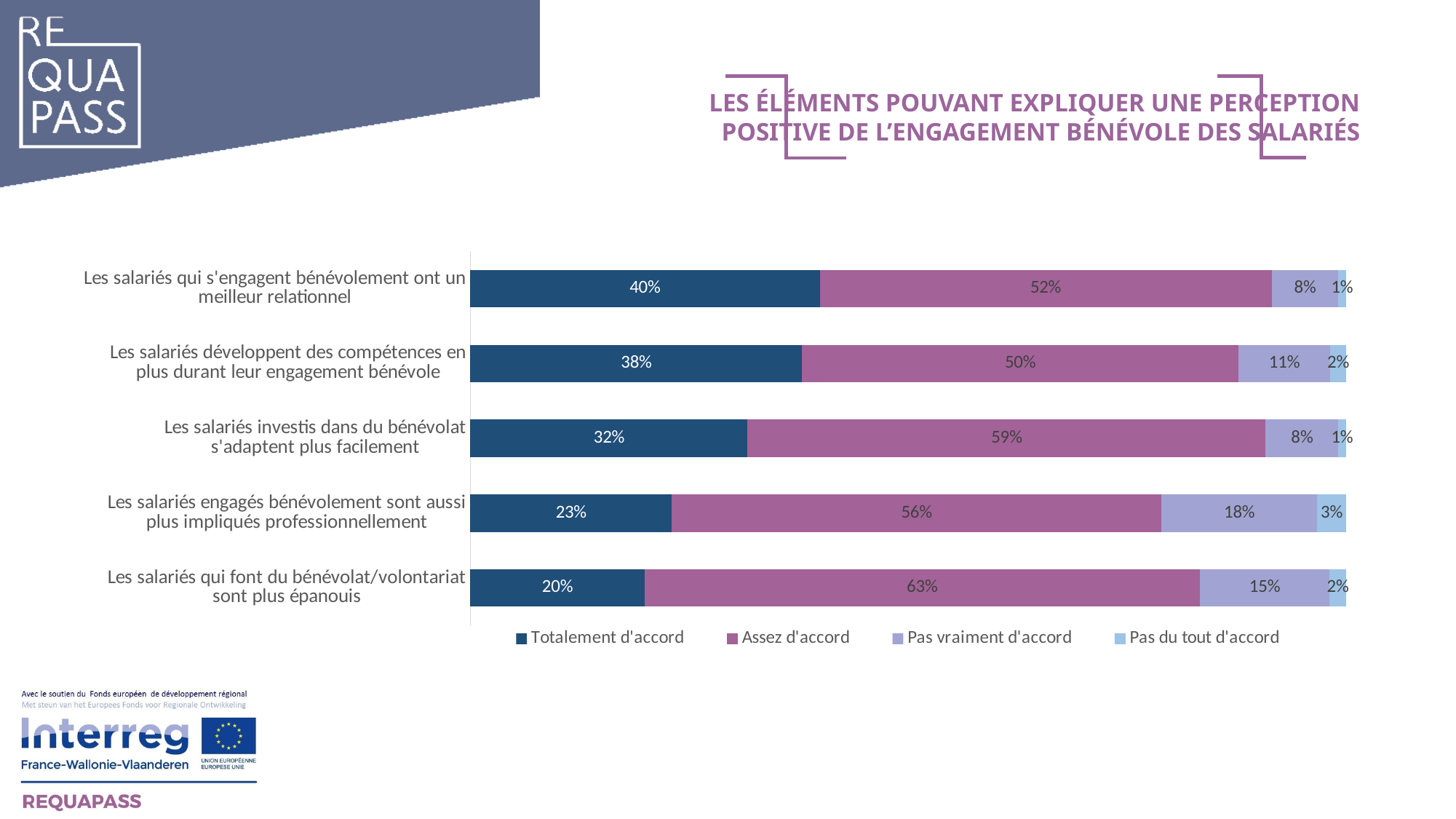
What kind of chart is shown on the slide? Stacked bar chart Which statement has the highest 'Totalement d'accord' share? Les salariés qui s'engagent bénévolement ont un meilleur relationnel Which statement has the lowest 'Totalement d'accord' share? Les salariés qui font du bénévolat/volontariat sont plus épanouis What is the 'Assez d'accord' value for 'Les salariés qui font du bénévolat/volontariat sont plus épanouis'? 63% How many statements (categories) are shown in the chart? 5 How many series does the legend list? 4 What is the difference between the 'Assez d'accord' values for 'sont plus épanouis' (63%) and 'ont un meilleur relationnel' (52%)? 11% What is the total of the stacked bar for 'Les salariés investis dans du bénévolat s'adaptent plus facilement'? 100% What percentage of respondents are 'Totalement d'accord' that employees who volunteer have better interpersonal relations (meilleur relationnel)? 40% What is the 'Pas vraiment d'accord' value for 'Les salariés engagés bénévolement sont aussi plus impliqués professionnellement'? 18% Which is larger: the 'Pas vraiment d'accord' value for 'plus impliqués professionnellement' or for 'sont plus épanouis'? plus impliqués professionnellement What is the 'Pas du tout d'accord' value for 'Les salariés développent des compétences en plus durant leur engagement bénévole'? 2%